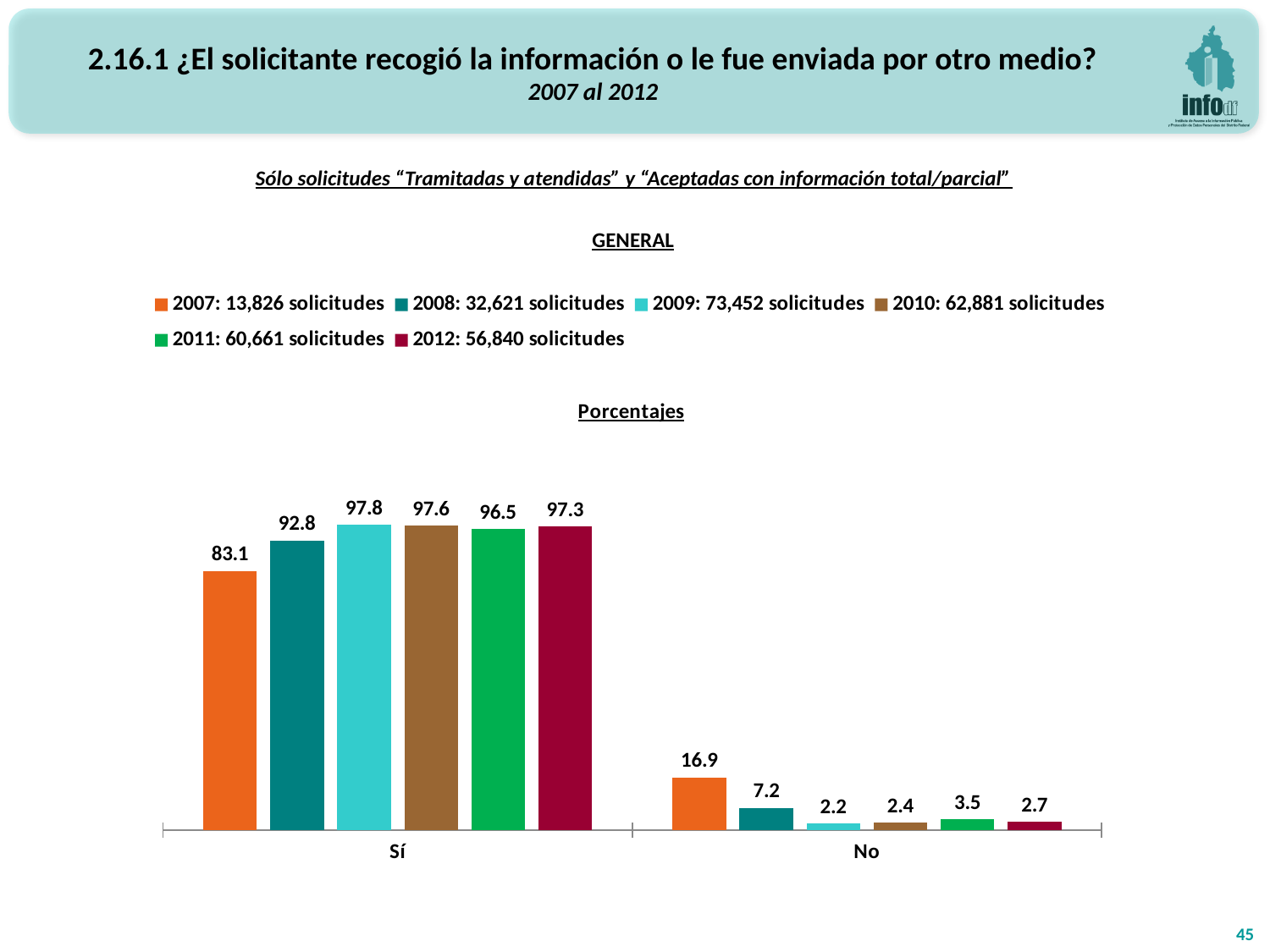
What is the value for 2012 in the Sí category? 97.3 Which year has the lowest value in the No category? 2009 Which is larger: the 2011 value or the 2010 value in the No category? 2011 What is the value for 2009 in the No category? 2.2 Which year has the highest value in the Sí category? 2009 What is the value for 2007 in the Sí category? 83.1 What is the difference between the 2007 and 2008 values in the Sí category? 9.7 What kind of chart is shown on the slide? bar chart How many categories are shown on the x axis? 2 According to the legend, how many solicitudes were there in 2009? 73,452 Which year has the highest value in the No category? 2007 How many series does the legend list? 6